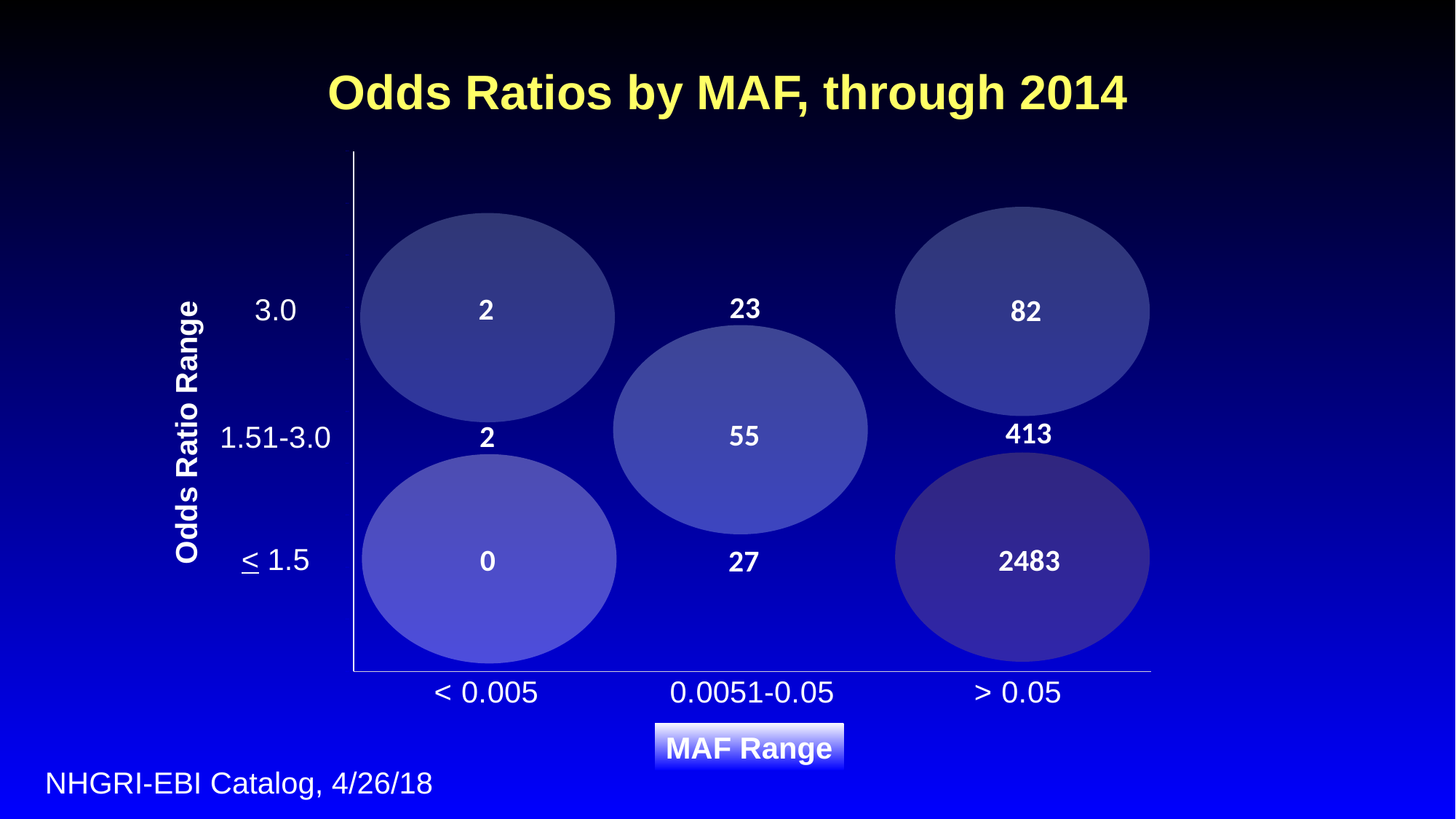
How many MAF range categories are shown on the x axis? 3 Which cell in the grid has the highest value? MAF > 0.05, odds ratio ≤ 1.5 (2483) What is the value for the MAF range > 0.05 and odds ratio range 3.0? 82 What is the title of the chart? Odds Ratios by MAF, through 2014 What is the label of the y axis? Odds Ratio Range What is the difference between the values for MAF > 0.05 in the 1.51-3.0 row and the 3.0 row? 331 What is the value for the MAF range > 0.05 and odds ratio range ≤ 1.5? 2483 What is the total of the values in the MAF < 0.005 column? 4 Which is larger: the value for MAF 0.0051-0.05 at odds ratio 3.0, or at odds ratio ≤ 1.5? ≤ 1.5 (27) What is the value for the MAF range 0.0051-0.05 and odds ratio range 1.51-3.0? 55 What is the value for the MAF range < 0.005 and odds ratio range 3.0? 2 Which cell in the grid has the lowest value? MAF < 0.005, odds ratio ≤ 1.5 (0)